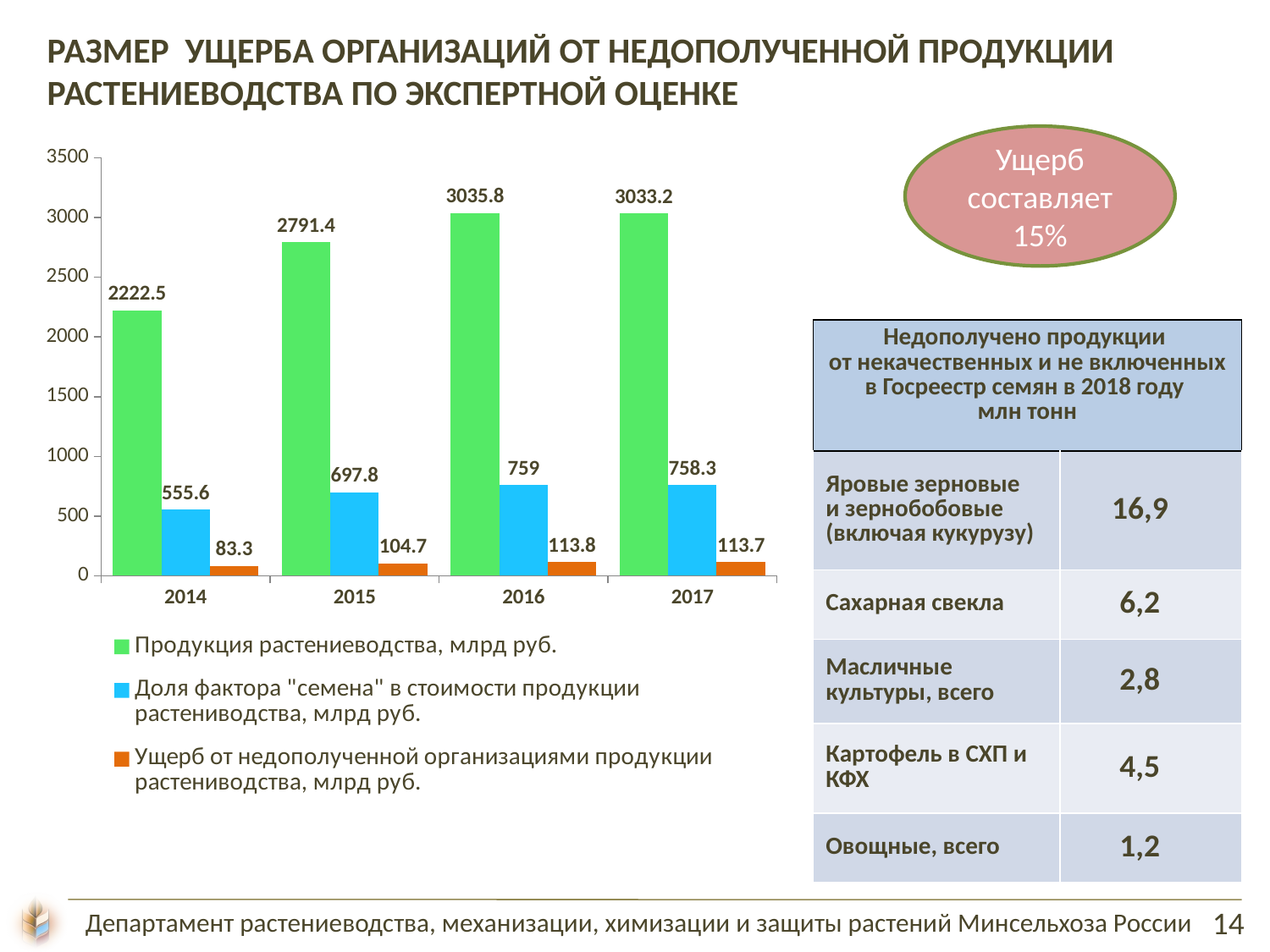
Which is larger: "Доля фактора "семена"" in 2015 or in 2016? 2016 How many series does the chart legend list? 3 What is the value of "Ущерб от недополученной организациями продукции растениводства, млрд руб." for 2014? 83.3 In which year is "Ущерб от недополученной организациями продукции растениводства, млрд руб." the highest? 2016 In which year is "Продукция растениеводства, млрд руб." the lowest? 2014 What is the value of "Доля фактора "семена" в стоимости продукции растениводства, млрд руб." for 2015? 697.8 What is the value of "Продукция растениеводства, млрд руб." for 2016? 3035.8 What type of chart is shown on the slide? bar chart Is the value of "Продукция растениеводства, млрд руб." for 2015 greater or less than 2500? greater What is the difference between the "Ущерб от недополученной организациями продукции растениводства, млрд руб." values for 2016 and 2014? 30.5 What is the difference between the "Продукция растениеводства, млрд руб." values for 2017 and 2014? 810.7 How many years are shown on the x axis of the chart? 4